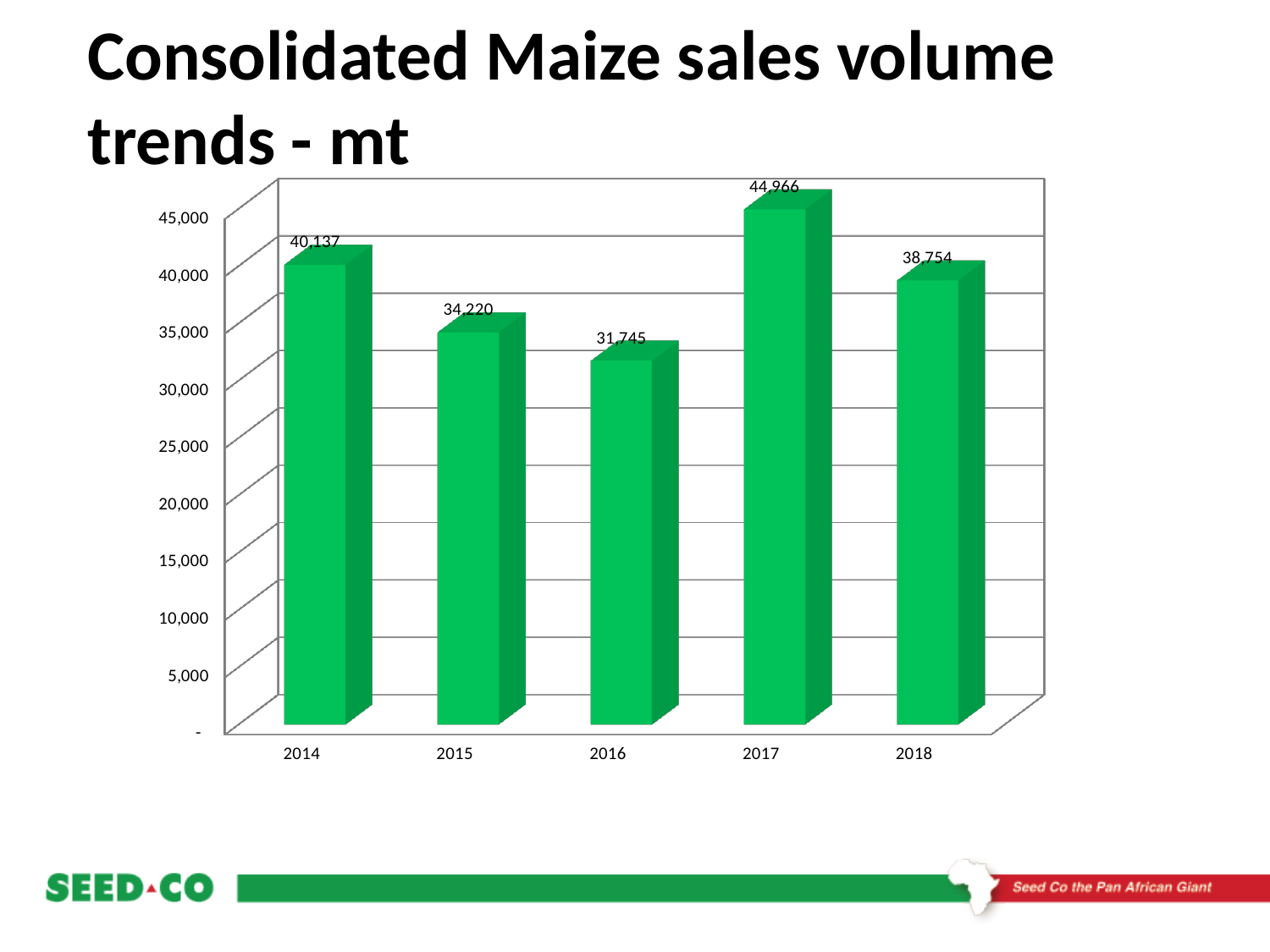
How many years are shown on the chart? 5 What was the consolidated maize sales volume in 2016? 31,745 What is the difference in maize sales volume between 2014 and 2015? 5,917 What is the difference in maize sales volume between 2017 and 2016? 13,221 What was the consolidated maize sales volume in 2018? 38,754 Which year had the highest maize sales volume? 2017 Is the maize sales volume for 2017 greater or less than 40,000? greater Which year had a larger maize sales volume, 2015 or 2018? 2018 What kind of chart is shown on the slide? Bar chart Which year had the lowest maize sales volume? 2016 What was the consolidated maize sales volume in 2014? 40,137 Did the maize sales volume rise or fall from 2014 to 2016? Fall